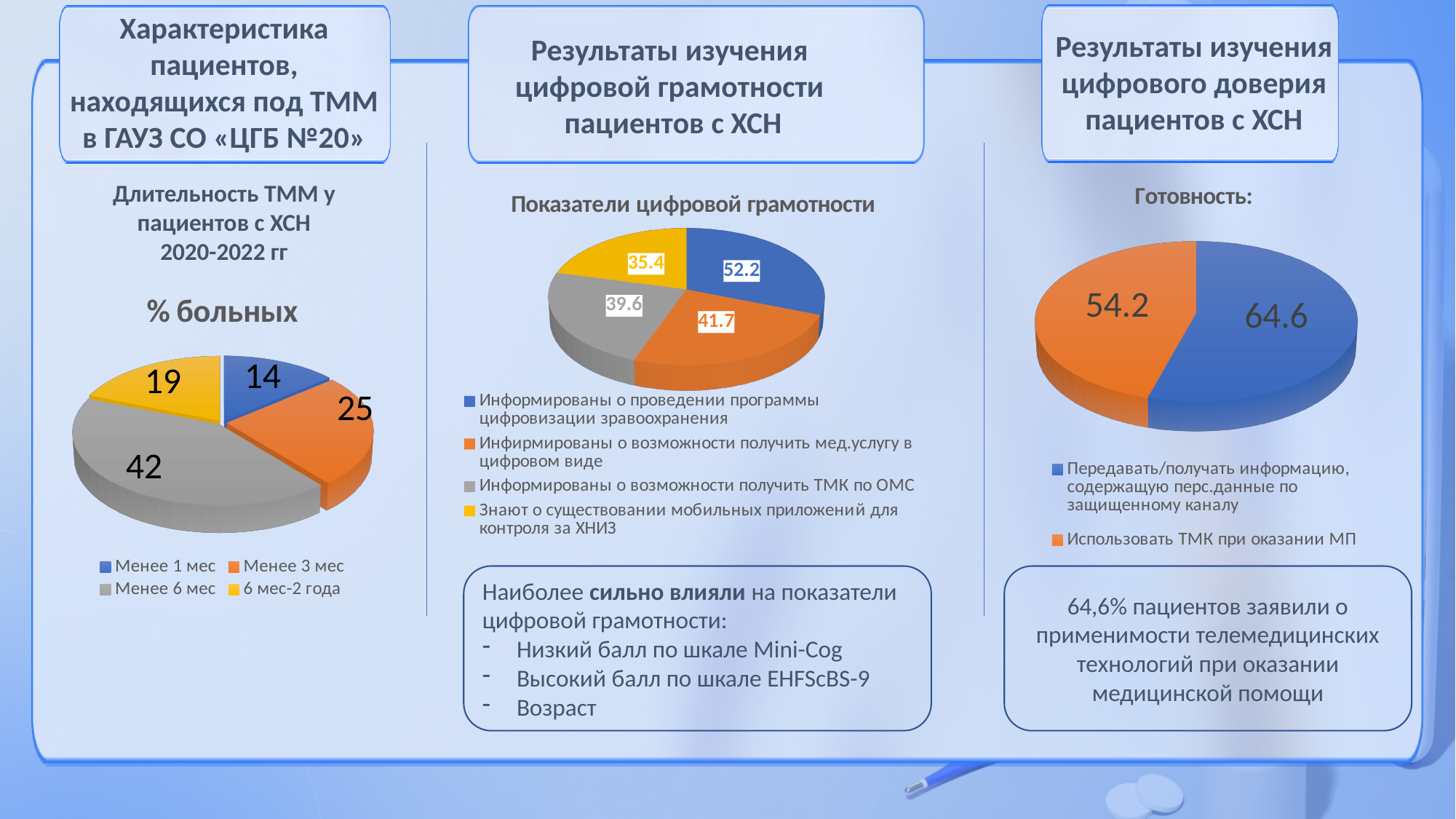
In the middle chart titled 'Показатели цифровой грамотности', what is the value for 'Информированы о возможности получить ТМК по ОМС'? 39.6 In the left chart titled '% больных', what share of the pie does the 'Менее 6 мес' slice represent? 42% In the middle chart titled 'Показатели цифровой грамотности', what is the value for 'Знают о существовании мобильных приложений для контроля за ХНИЗ'? 35.4 In the left chart titled '% больных', how many categories does the legend list? 4 In the right chart titled 'Готовность:', which is larger: 'Передавать/получать информацию, содержащую перс.данные по защищенному каналу' or 'Использовать ТМК при оказании МП'? Передавать/получать информацию, содержащую перс.данные по защищенному каналу In the right chart titled 'Готовность:', what is the value for 'Использовать ТМК при оказании МП'? 54.2 In the left chart titled '% больных', which category has the smallest value? Менее 1 мес In the middle chart titled 'Показатели цифровой грамотности', what is the difference between the values 52.2 and 41.7? 10.5 In the left chart titled '% больных', what is the value for 'Менее 6 мес'? 42 What type of chart is the right chart titled 'Готовность:'? Pie chart In the left chart titled '% больных', what is the difference between the values for 'Менее 3 мес' and 'Менее 1 мес'? 11 In the middle chart titled 'Показатели цифровой грамотности', which category has the highest value? Информированы о проведении программы цифровизации зравоохранения